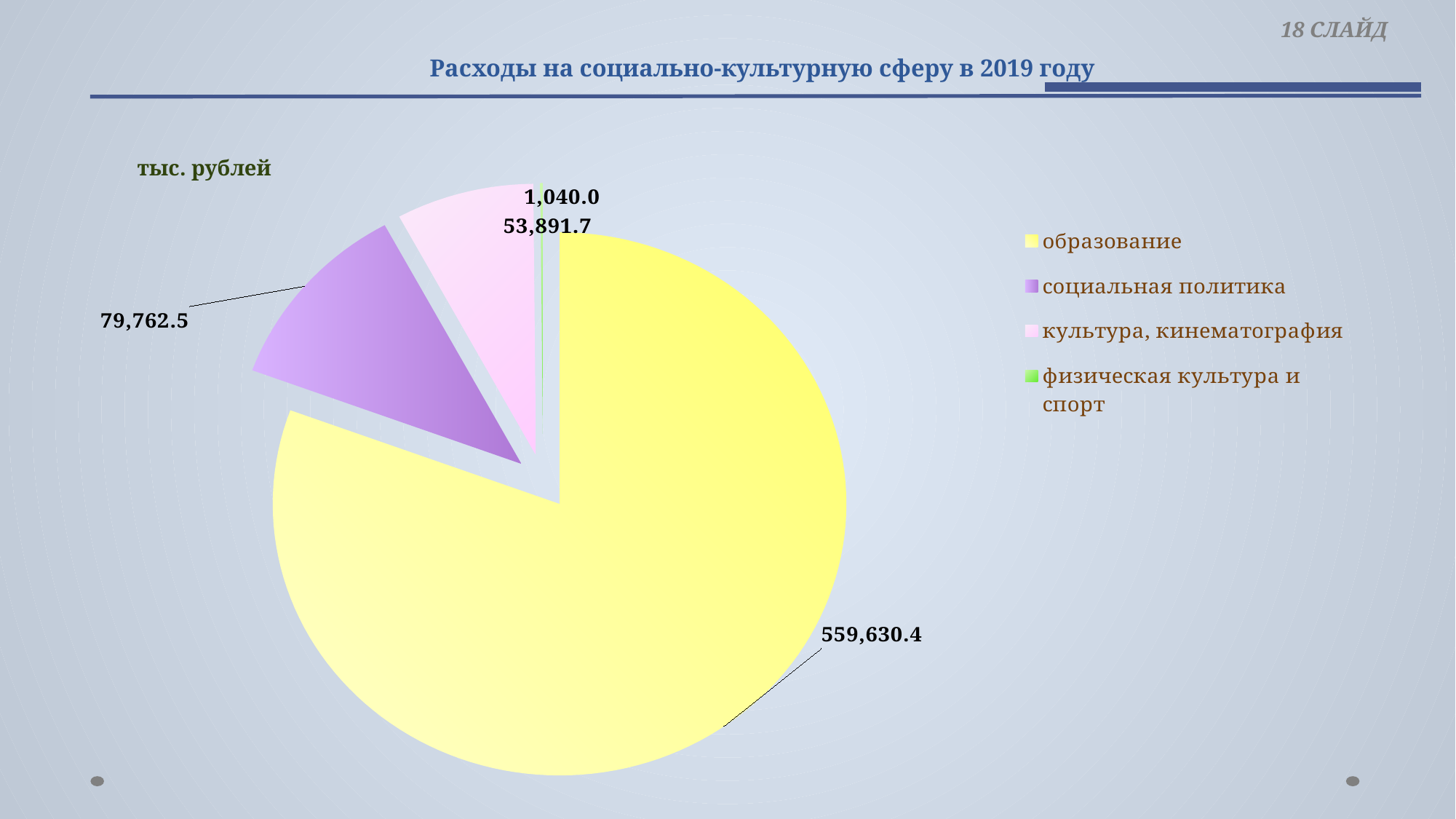
What is the value for образование? 559,630.4 What is the title of the chart? Расходы на социально-культурную сферу в 2019 году In what units are the values on the chart given? тыс. рублей What is the difference between the values for социальная политика and культура, кинематография? 25,870.8 What kind of chart is shown on the slide? pie chart Which category has the smallest slice of the pie? физическая культура и спорт Which is larger, the value for социальная политика or the value for культура, кинематография? социальная политика What is the value for социальная политика? 79,762.5 What is the value for культура, кинематография? 53,891.7 What is the value for физическая культура и спорт? 1,040.0 How many categories does the pie chart show? 4 Which category has the largest slice of the pie? образование